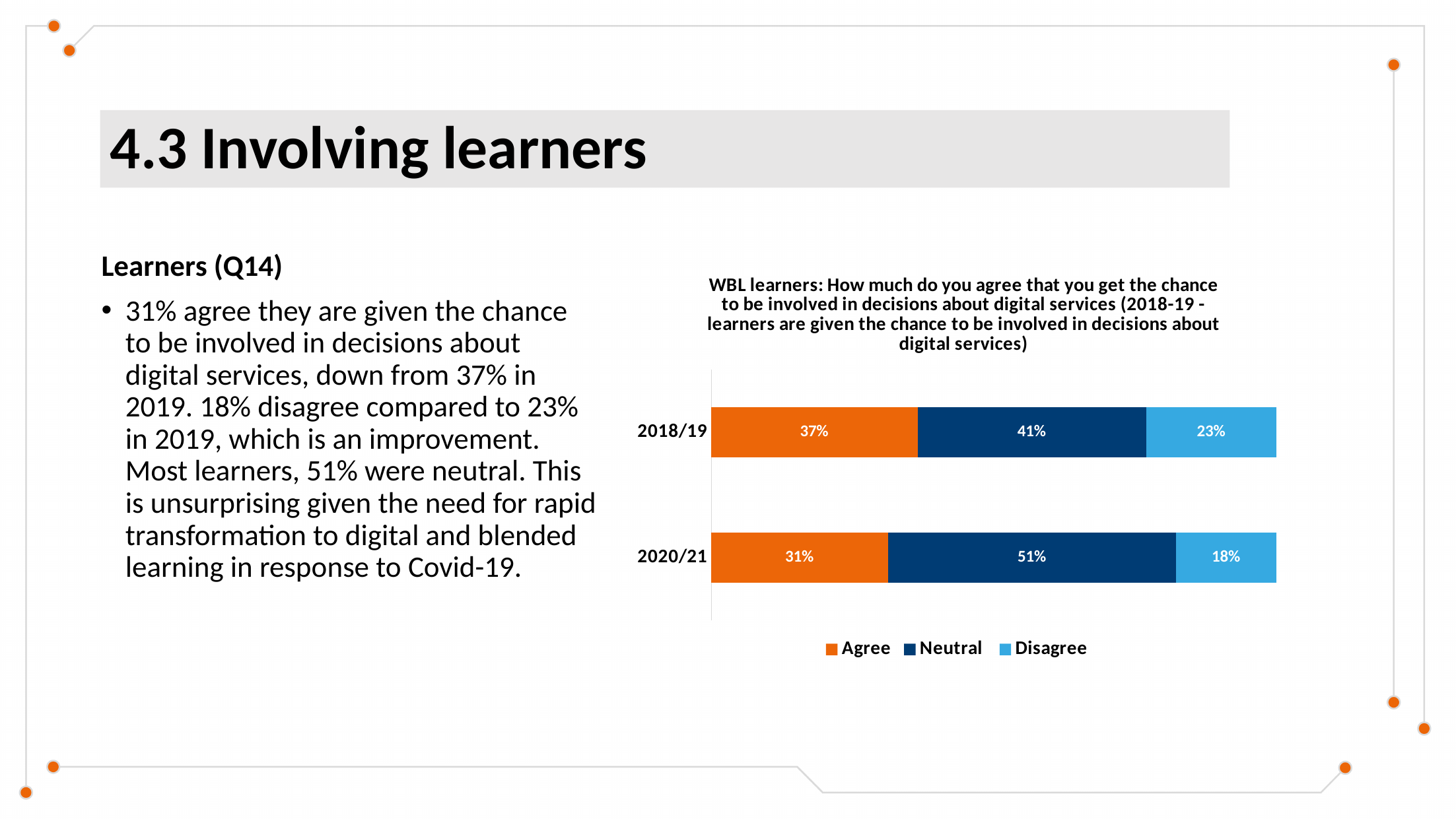
Which year has the higher Neutral share? 2020/21 By how many percentage points did the Agree share fall from 2018/19 to 2020/21? 6% Which colour represents the Agree series in the chart? Orange What percentage of WBL learners agreed in 2020/21? 31% What percentage of WBL learners were neutral in 2018/19? 41% What percentage of WBL learners agreed in 2018/19? 37% Is the Disagree share larger in 2018/19 or 2020/21? 2018/19 What percentage of WBL learners disagreed in 2020/21? 18% How many series does the legend list? 3 What is the difference between the Neutral share in 2020/21 and in 2018/19? 10% Which year has the lower Disagree share? 2020/21 What kind of chart is shown on the slide? Stacked bar chart